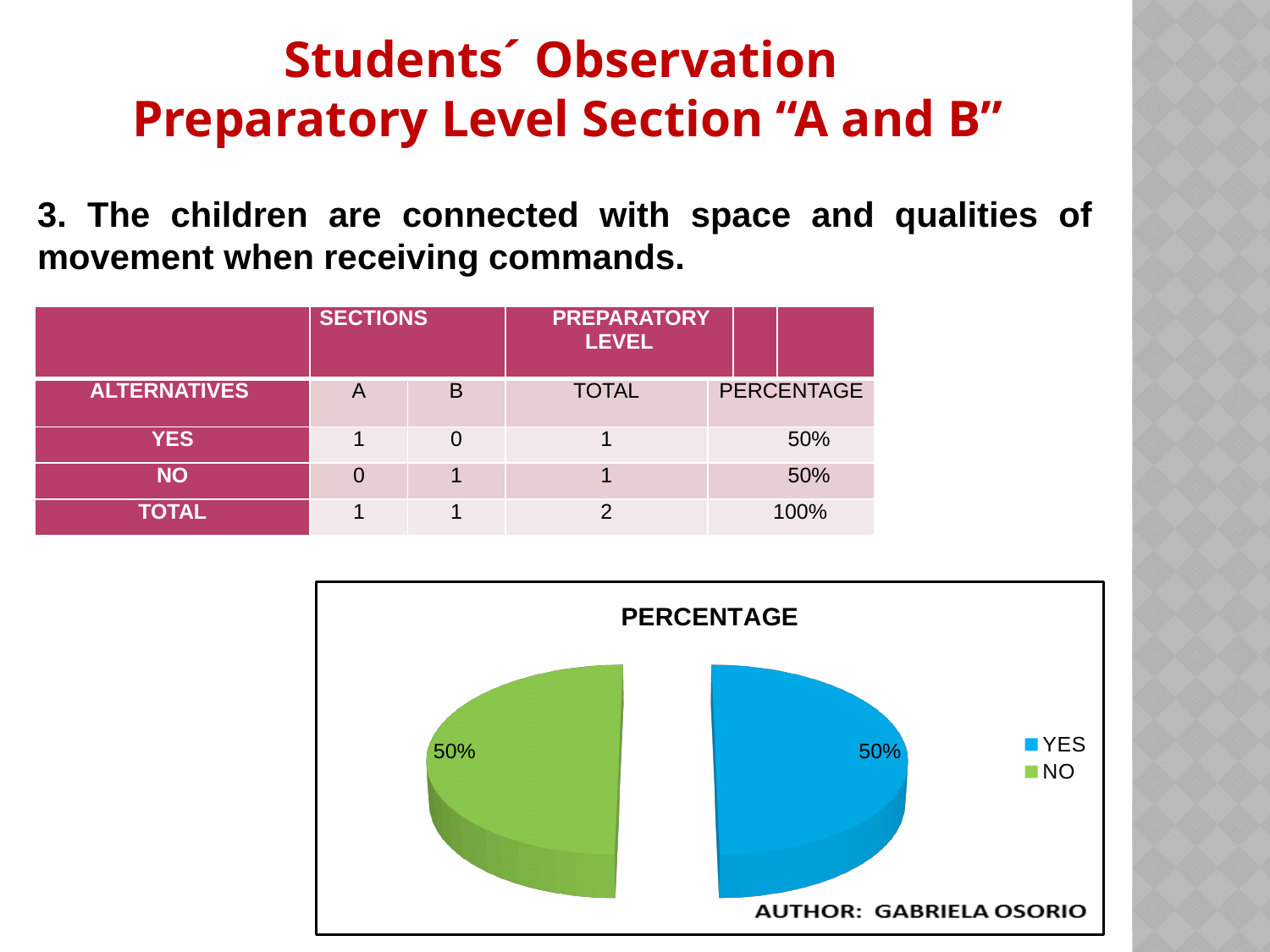
What is the difference between the YES and NO percentages in the pie chart? 0% What percentage does the NO slice show in the pie chart? 50% What kind of chart is shown on the slide? pie chart What share of the pie does the NO slice take? 50% How many slices does the pie chart have? 2 What percentage does the YES slice show in the pie chart? 50% Which colour represents YES in the pie chart? blue How many entries does the chart legend list? 2 What is the title of the chart? PERCENTAGE What is the total of the YES and NO slices in the pie chart? 100%